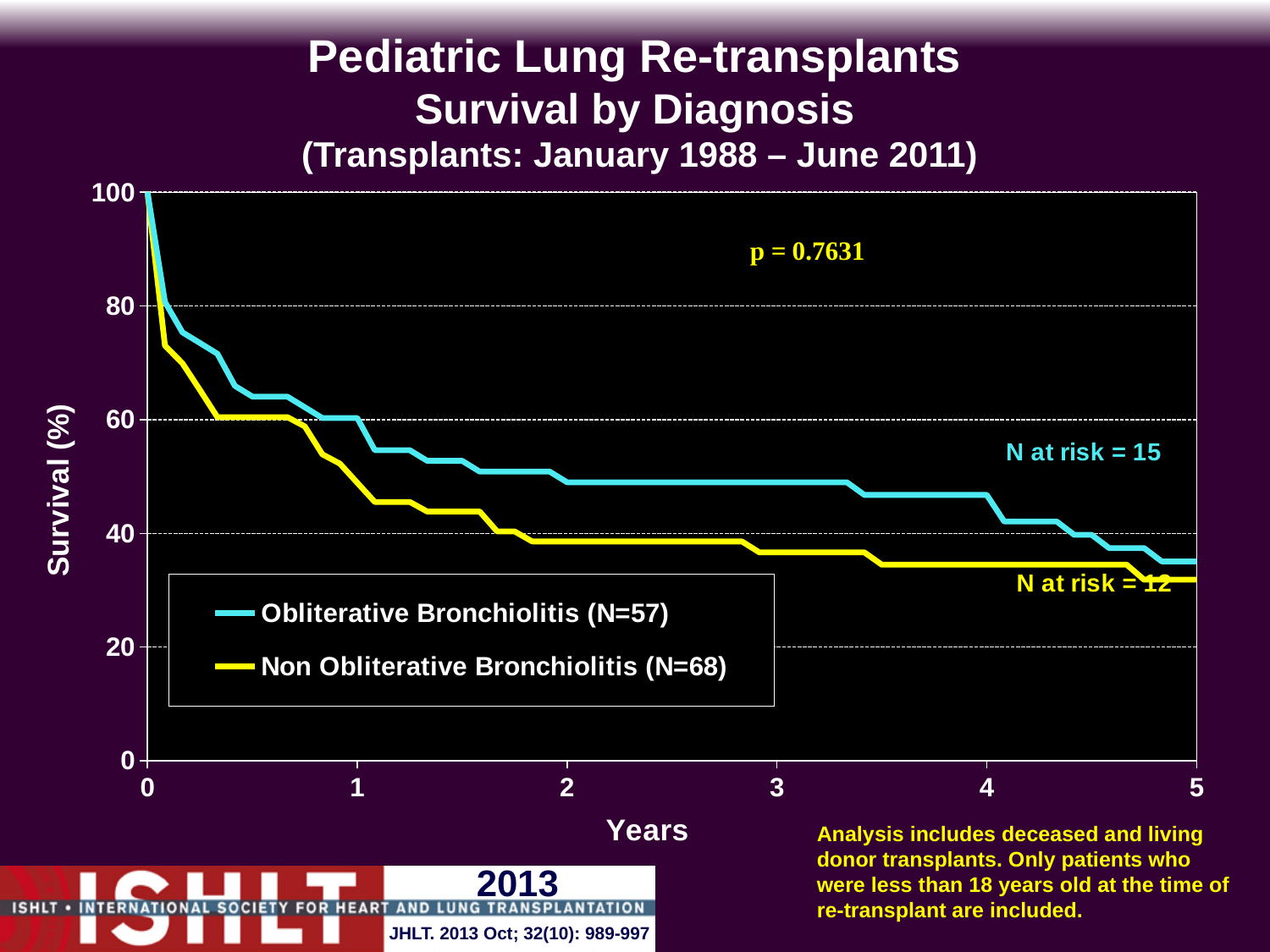
What kind of chart is shown on the slide? line chart Do the survival curves rise or fall as years increase? fall Is the survival for Obliterative Bronchiolitis at 5 years greater or less than 40%? less What is the label of the x axis? Years What are the two series named in the legend? Obliterative Bronchiolitis (N=57) and Non Obliterative Bronchiolitis (N=68) What is the N at risk shown for the Non Obliterative Bronchiolitis curve? 12 What is the N at risk shown for the Obliterative Bronchiolitis curve? 15 What p value is printed on the chart? p = 0.7631 How many patients (N) are in the Non Obliterative Bronchiolitis group according to the legend? 68 How many series does the legend list? 2 Is the survival for Non Obliterative Bronchiolitis at 1 year greater or less than 60%? less At 3 years, which curve shows higher survival: Obliterative Bronchiolitis or Non Obliterative Bronchiolitis? Obliterative Bronchiolitis